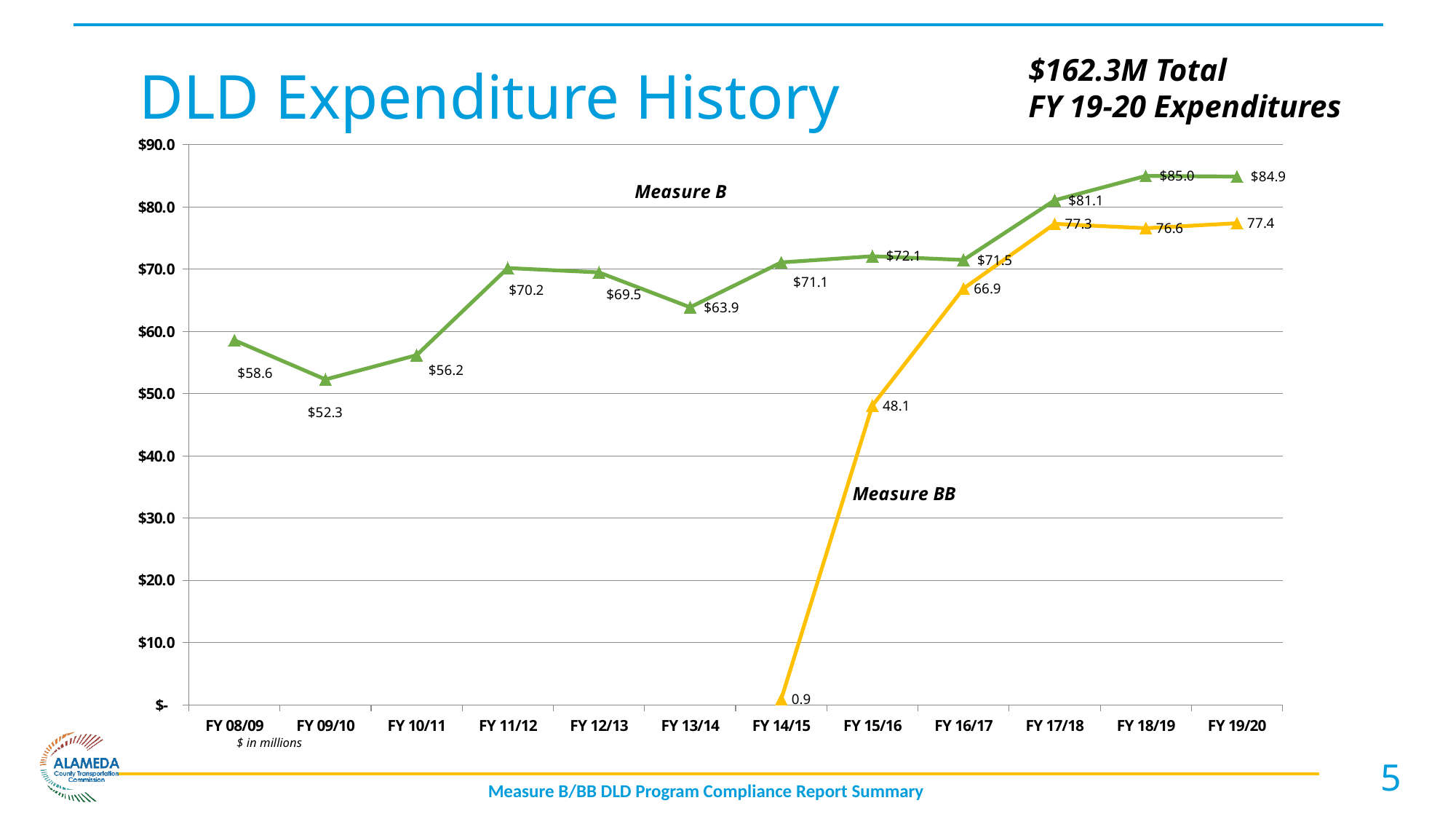
By how much did Measure B increase from FY 16/17 to FY 17/18? 9.6 What is the Measure B value for FY 11/12? $70.2 What kind of chart is shown on the slide? line chart In which fiscal year is the Measure B value lowest? FY 09/10 Does the Measure BB line rise or fall from FY 14/15 to FY 17/18? rise Which is larger for Measure B: the FY 12/13 value or the FY 13/14 value? FY 12/13 In which fiscal year is the Measure B value highest? FY 18/19 How many fiscal years are shown on the x axis? 12 What is the difference between the Measure B and Measure BB values in FY 19/20? 7.5 What is the Measure BB value for FY 14/15? 0.9 What is the Measure BB value for FY 15/16? 48.1 Is the Measure B value for FY 08/09 greater or less than $60.0? less